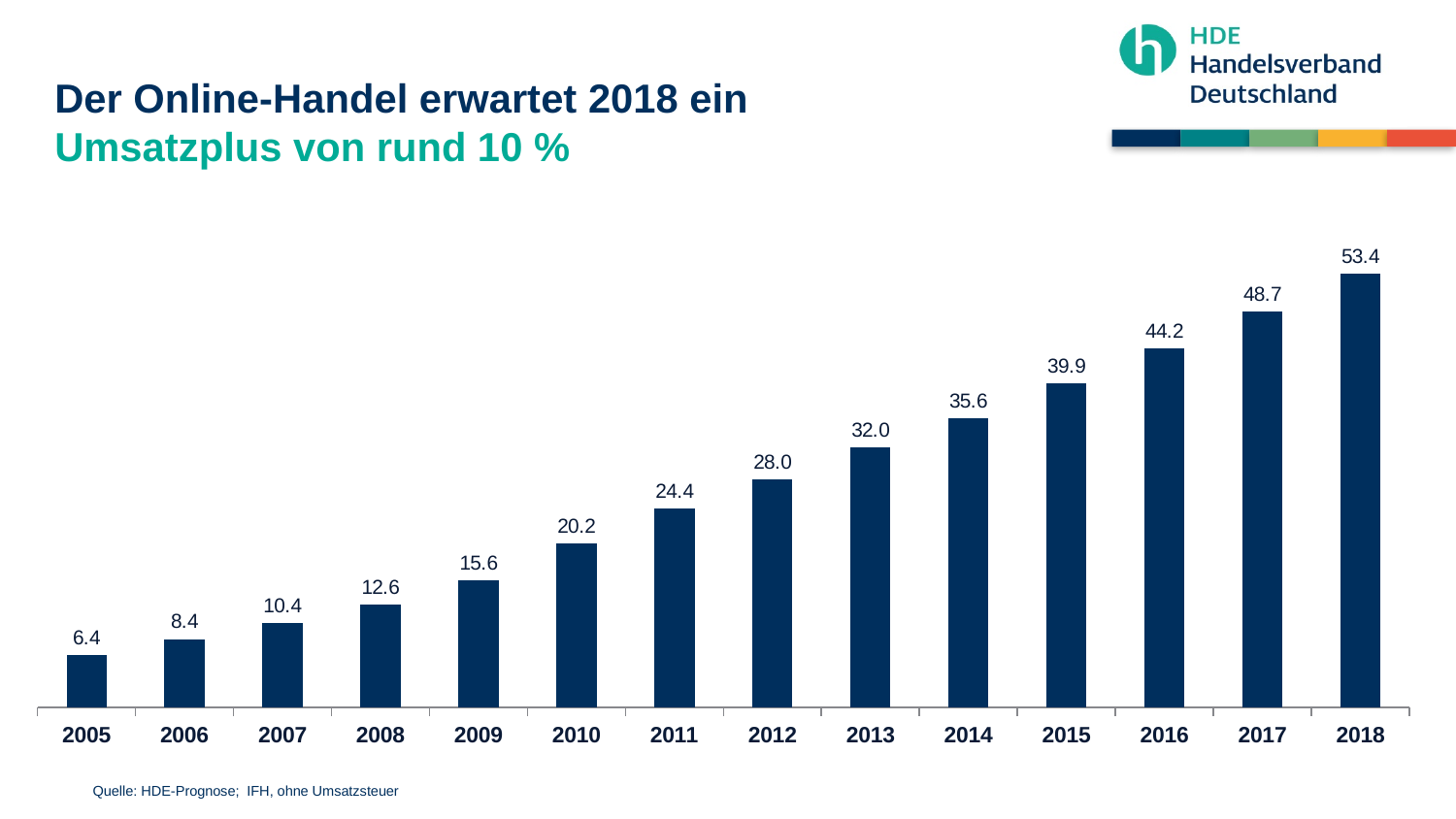
Which year has the highest value? 2018 What is the value shown for 2010? 20.2 How many years are shown on the x axis? 14 Do the values rise or fall from 2005 to 2018? Rise What is the value shown for 2018? 53.4 What is the value shown for 2005? 6.4 What kind of chart is shown on the slide? Bar chart What source is cited below the chart? HDE-Prognose; IFH, ohne Umsatzsteuer What is the difference between the values for 2018 and 2017? 4.7 What is the difference between the values for 2013 and 2005? 25.6 Which year has the lowest value? 2005 Which is larger, the value for 2012 or the value for 2014? 2014